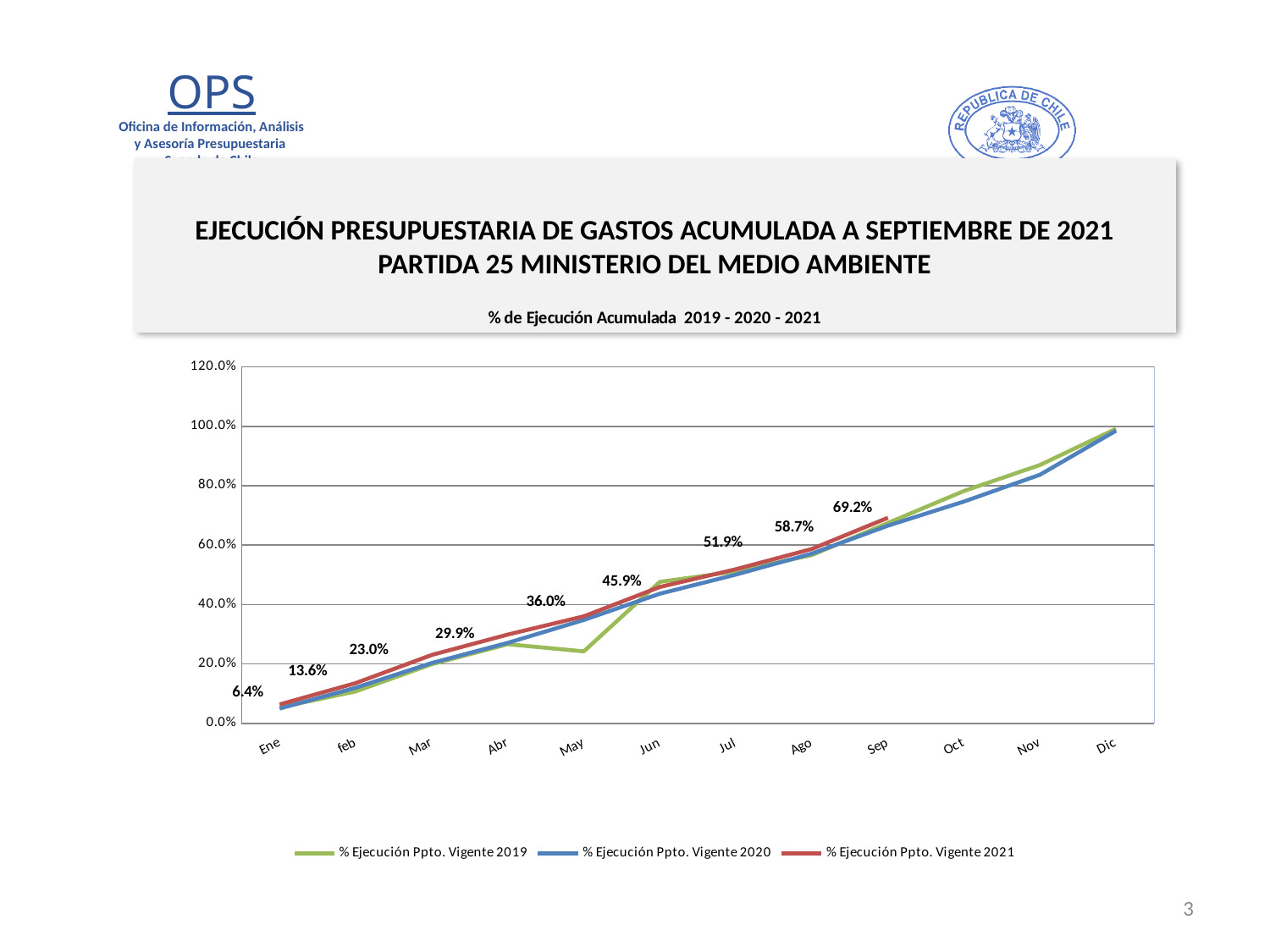
What is the % Ejecución Ppto. Vigente 2021 value for Ene? 6.4% Does the % Ejecución Ppto. Vigente 2021 series rise or fall from Ene to Sep? rise What is the title of the chart? % de Ejecución Acumulada 2019 - 2020 - 2021 What is the difference between the 2021 values for Jun and May? 9.9% What is the difference between the 2021 values for Sep and Ago? 10.5% What is the % Ejecución Ppto. Vigente 2021 value for Sep? 69.2% How many series does the legend list? 3 What is the % Ejecución Ppto. Vigente 2021 value for Jul? 51.9% Is the % Ejecución Ppto. Vigente 2019 value for May greater or less than 40.0%? less What type of chart is shown on the slide? line chart How many months are labelled on the x axis? 12 What is the % Ejecución Ppto. Vigente 2021 value for May? 36.0%